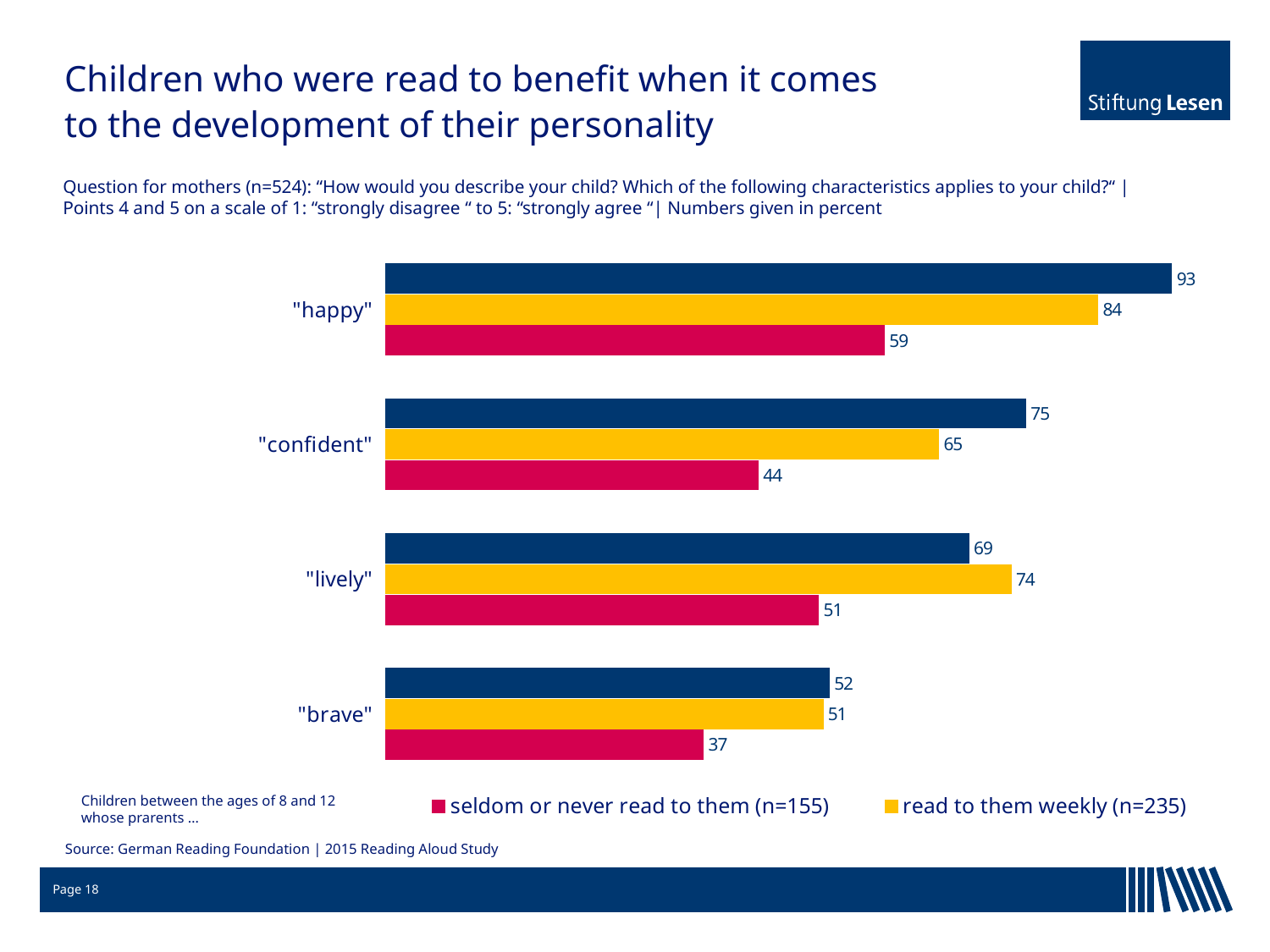
What kind of chart is shown on the slide? bar chart What value is shown on the dark blue bar for "happy"? 93 How many series does the legend list? 2 For "lively", which series has the larger value: "seldom or never read to them (n=155)" or "read to them weekly (n=235)"? read to them weekly (n=235) Which characteristic has the highest value in the "seldom or never read to them (n=155)" series? "happy" What is the value for "confident" in the "seldom or never read to them (n=155)" series? 44 How many characteristics are shown on the chart? 4 What is the value for "lively" in the "read to them weekly (n=235)" series? 74 For "happy", what is the difference between the "read to them weekly (n=235)" value and the "seldom or never read to them (n=155)" value? 25 What is the value for "brave" in the "seldom or never read to them (n=155)" series? 37 What is the value for "happy" in the "read to them weekly (n=235)" series? 84 Which characteristic has the lowest value in the "read to them weekly (n=235)" series? "brave"